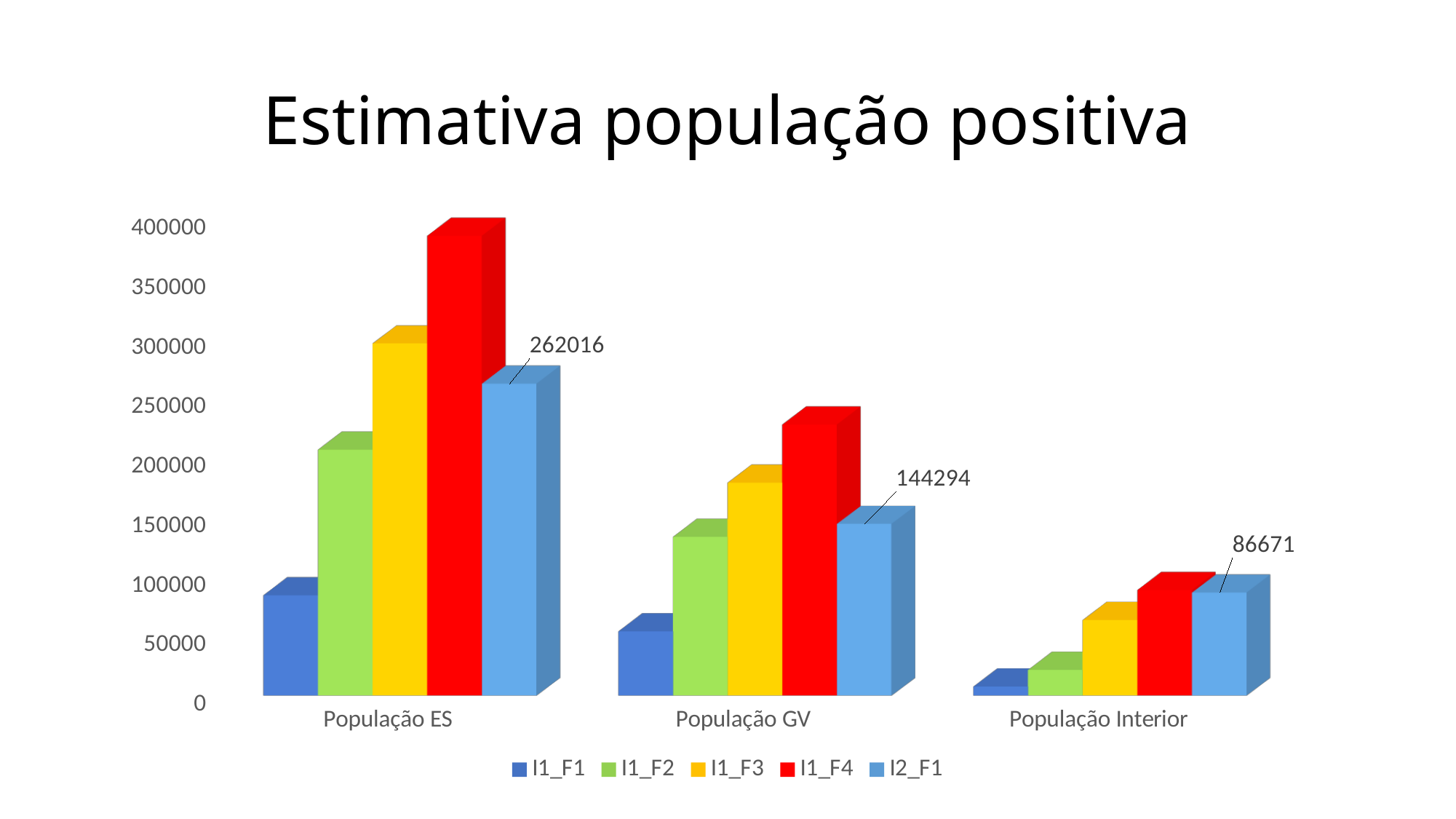
What is the difference between the I2_F1 values for População GV and População Interior? 57623 Which series has the highest value for População ES? I1_F4 What is the difference between the I2_F1 values for População ES and População GV? 117722 Is the value of I1_F1 for População ES greater or less than 100000? less What is the value of I2_F1 for População GV? 144294 Which series has the lowest value for População ES? I1_F1 For População ES, which is larger: I1_F4 or I2_F1? I1_F4 Which category has the highest I2_F1 value? População ES What is the value of I2_F1 for População Interior? 86671 Is the value of I1_F4 for População ES greater or less than 350000? greater How many series does the legend list? 5 What is the value of I2_F1 for População ES? 262016